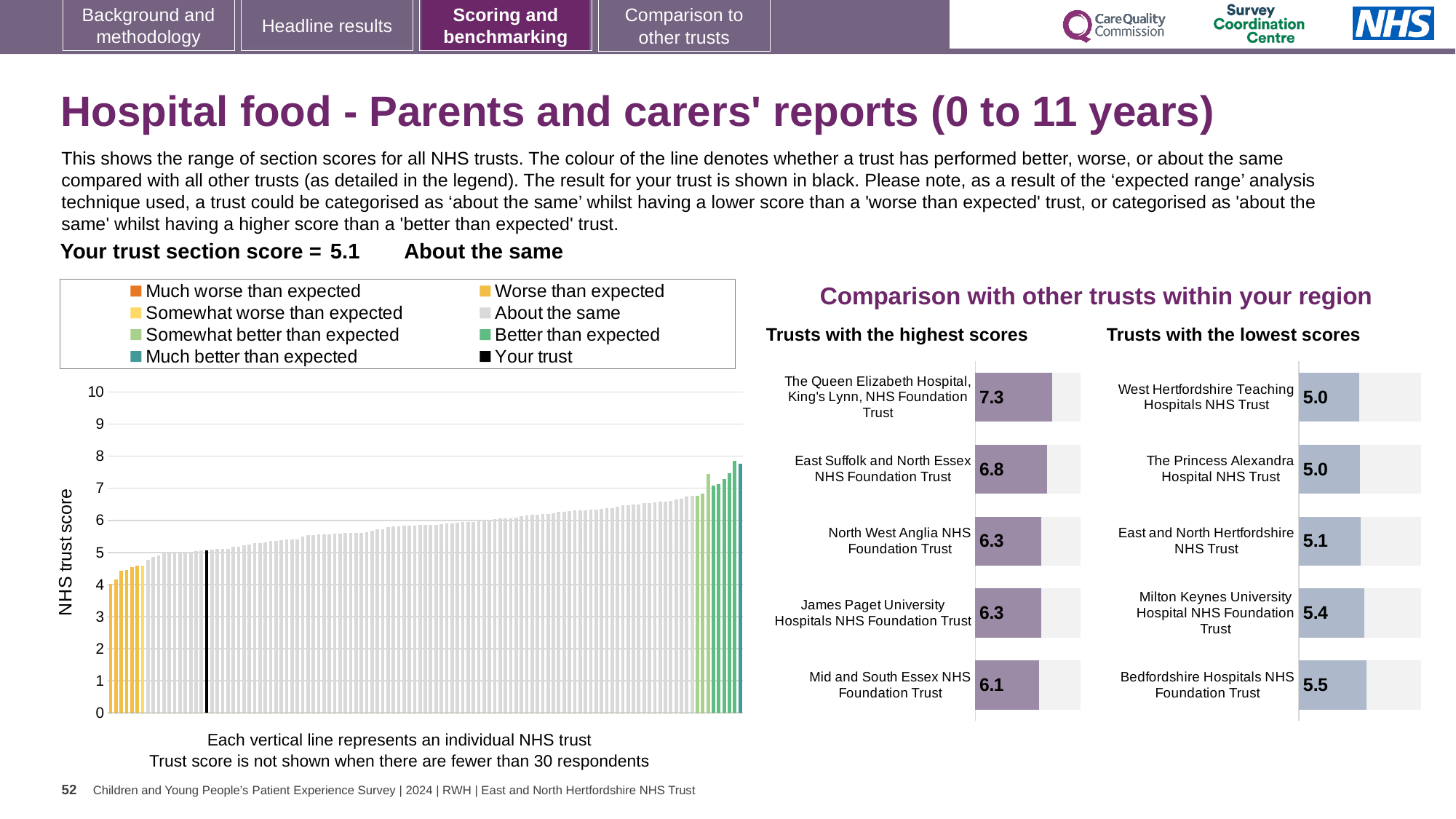
In the 'Trusts with the highest scores' chart, which trust has the lowest score? Mid and South Essex NHS Foundation Trust In the 'NHS trust score' chart, do the bar values rise or fall from left to right? Rise In the 'Trusts with the lowest scores' chart, what is the difference between the scores of Bedfordshire Hospitals NHS Foundation Trust and West Hertfordshire Teaching Hospitals NHS Trust? 0.5 Which has a higher score: East Suffolk and North Essex NHS Foundation Trust in the highest scores chart, or Milton Keynes University Hospital NHS Foundation Trust in the lowest scores chart? East Suffolk and North Essex NHS Foundation Trust In the 'Trusts with the highest scores' chart, what is the difference between the scores of The Queen Elizabeth Hospital, King's Lynn, NHS Foundation Trust and Mid and South Essex NHS Foundation Trust? 1.2 In the 'Trusts with the lowest scores' chart, what is the score for Milton Keynes University Hospital NHS Foundation Trust? 5.4 In the 'Trusts with the highest scores' chart, what is the score for Mid and South Essex NHS Foundation Trust? 6.1 How many entries does the legend of the 'NHS trust score' chart list? 8 In the 'Trusts with the lowest scores' chart, which trust has the highest score? Bedfordshire Hospitals NHS Foundation Trust In the 'Trusts with the highest scores' chart, what is the score for The Queen Elizabeth Hospital, King's Lynn, NHS Foundation Trust? 7.3 How many trusts are shown in the 'Trusts with the lowest scores' chart? 5 What kind of chart is the 'NHS trust score' chart on the left of the slide? Bar chart